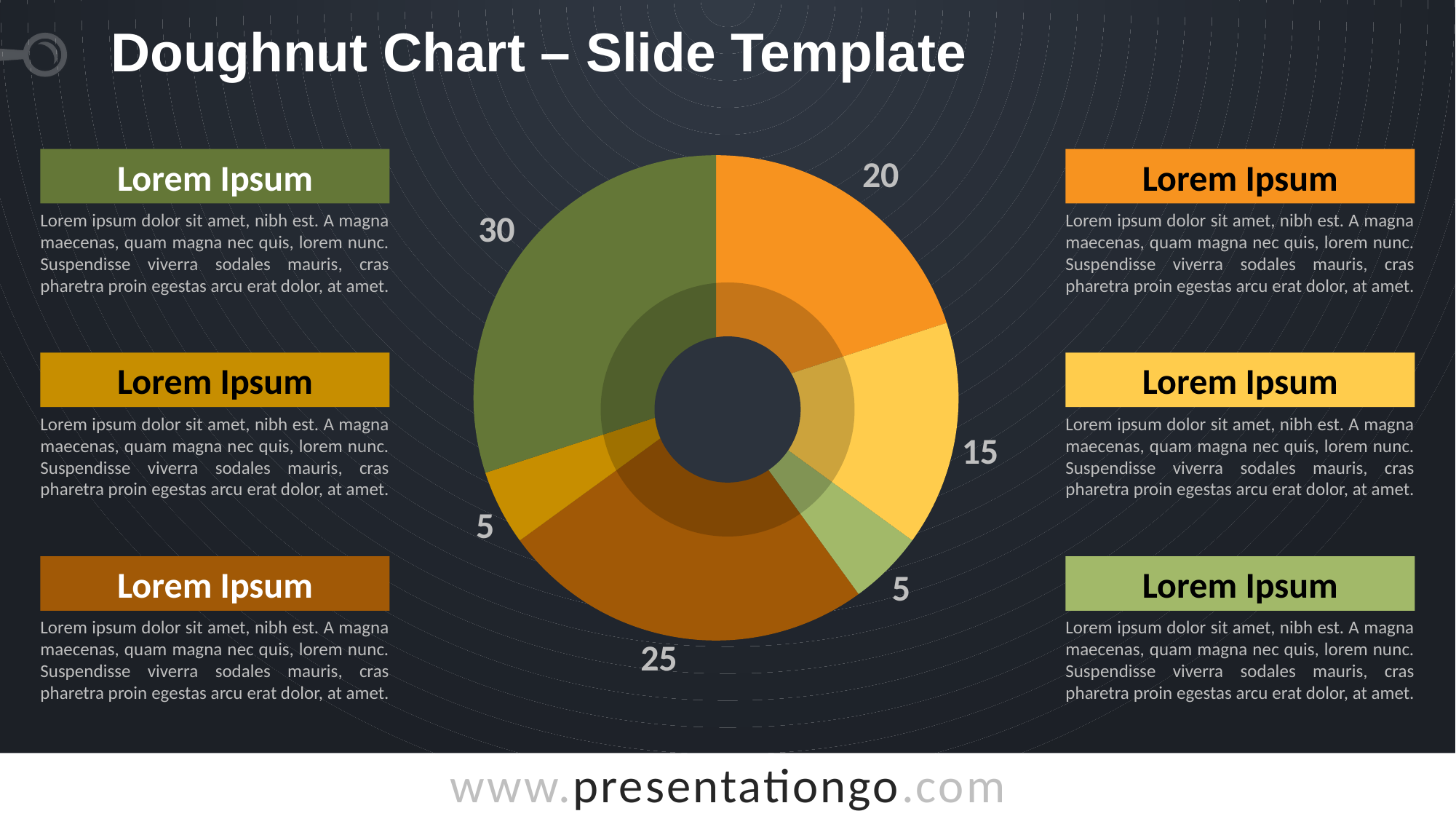
What is the value of the dark green slice of the doughnut chart? 30 What is the value of the brown slice of the doughnut chart? 25 How many slices does the doughnut chart have? 6 What is the difference between the dark green slice (30) and the orange slice (20)? 10 What is the smallest value shown on the doughnut chart? 5 What is the value of the orange slice of the doughnut chart? 20 Which is larger, the brown slice or the yellow slice? The brown slice What is the largest value shown on the doughnut chart? 30 What is the title of the slide? Doughnut Chart – Slide Template What is the value of the yellow slice of the doughnut chart? 15 What kind of chart is shown on the slide? Doughnut chart What is the total of all the slice values on the doughnut chart? 100